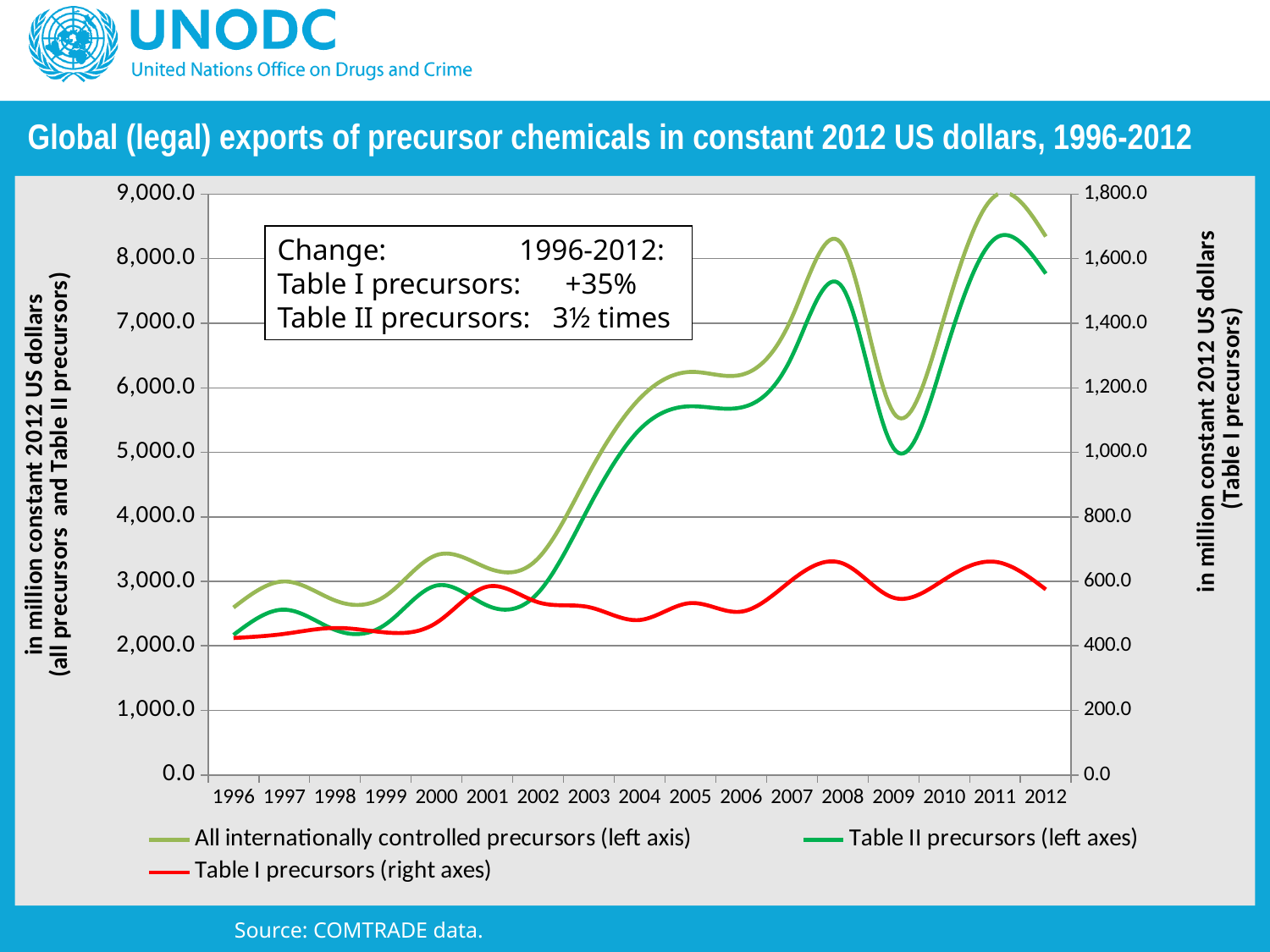
Overall, do the values for 'Table II precursors' rise or fall from 1996 to 2012? Rise Is the value for 'Table I precursors' in 1996 greater or less than 600.0 on the right axis? less Is the value for 'All internationally controlled precursors' in 2009 greater or less than 6,000.0 on the left axis? less What kind of chart is shown on the slide? Line chart Is the value for 'Table II precursors' in 2012 greater or less than 7,000.0 on the left axis? greater How many years are shown along the x axis? 17 In which year does the 'All internationally controlled precursors' series reach its highest value? 2011 According to the text box on the chart, by how much did Table I precursors change between 1996 and 2012? +35% How many series does the legend list? 3 Which year has the larger value for 'All internationally controlled precursors', 2008 or 2009? 2008